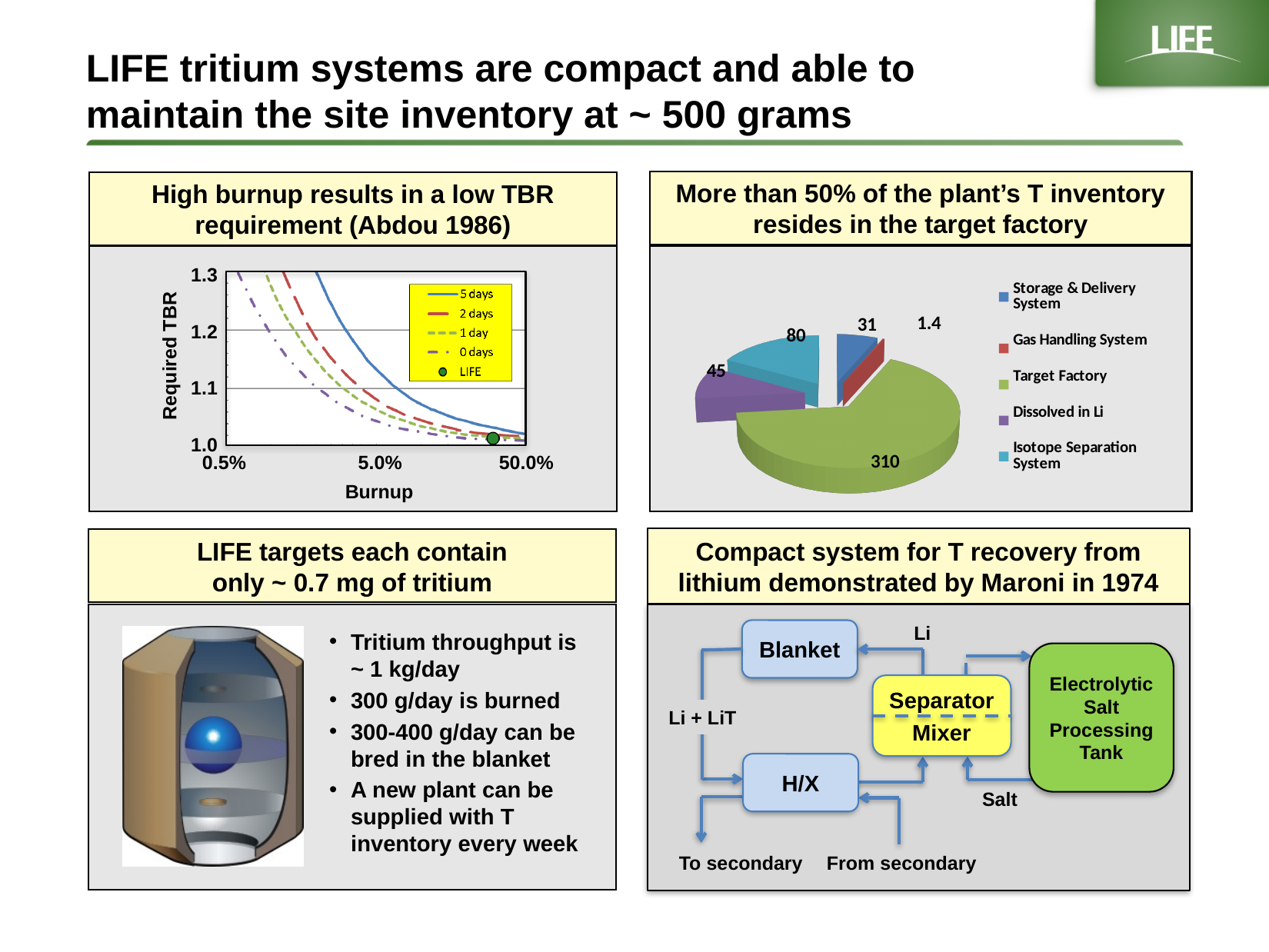
In the "High burnup results in a low TBR requirement" chart, what is the label of the y axis? Required TBR In the T inventory pie chart, what is the difference between the Isotope Separation System value and the Dissolved in Li value? 35 What kind of chart is shown in the panel titled "High burnup results in a low TBR requirement (Abdou 1986)"? line chart In the "High burnup results in a low TBR requirement" chart, how many entries does the legend list? 5 In the T inventory pie chart, which category has the largest value? Target Factory In the T inventory pie chart, which is larger: Storage & Delivery System or Dissolved in Li? Dissolved in Li In the "High burnup results in a low TBR requirement" chart, does the required TBR rise or fall as burnup increases? fall In the T inventory pie chart, what is the value for the Isotope Separation System? 80 What kind of chart is shown in the panel titled "More than 50% of the plant's T inventory resides in the target factory"? pie chart In the T inventory pie chart, which category has the smallest value? Gas Handling System In the T inventory pie chart, what is the value for the Target Factory? 310 In the "High burnup results in a low TBR requirement" chart, is the required TBR for the LIFE point greater or less than 1.1? less